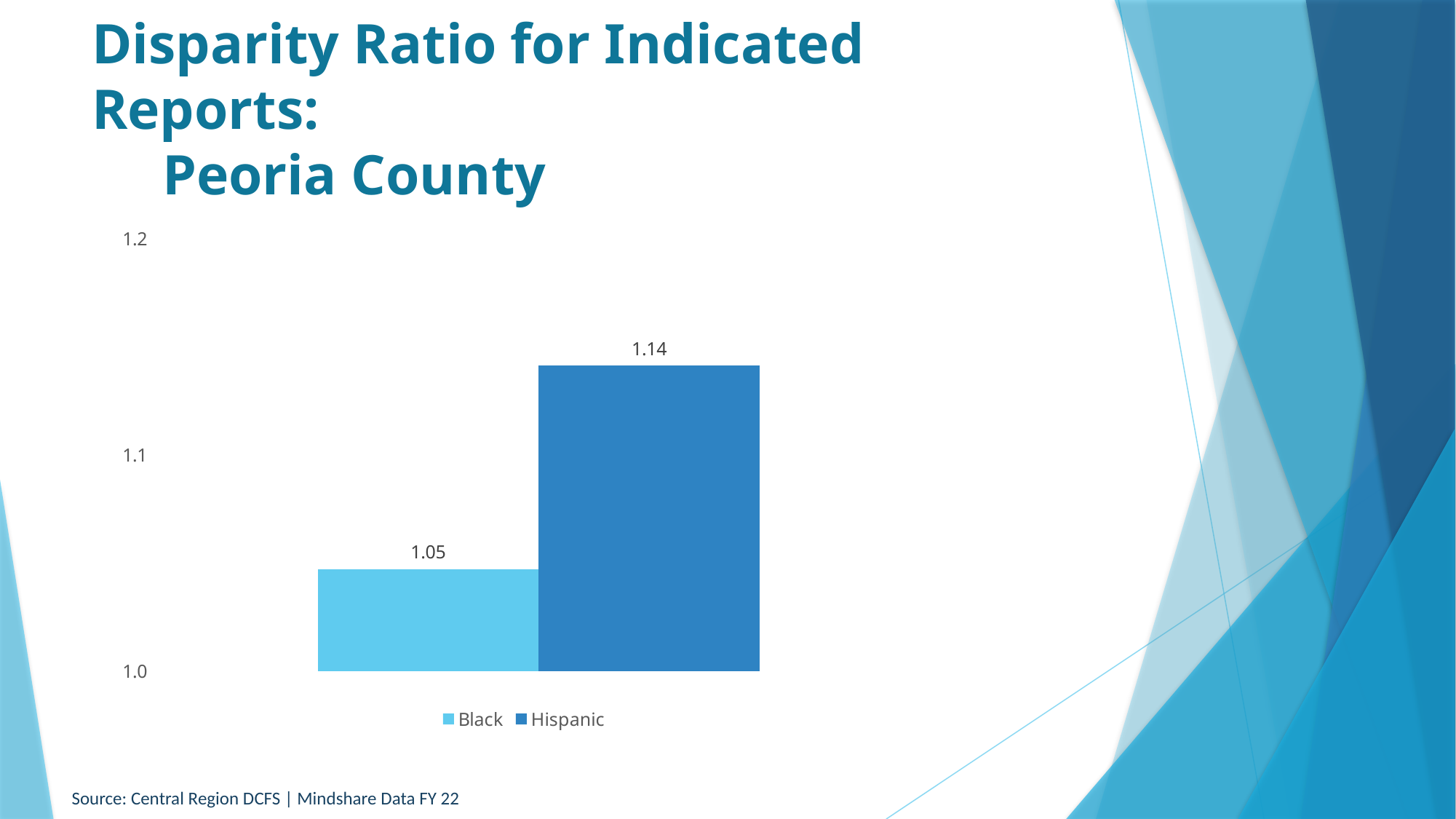
Is the value for Hispanic greater or less than 1.1? greater Is the disparity ratio for Black larger or smaller than the ratio for Hispanic? smaller What kind of chart is shown on the slide? bar chart What is the source cited for the chart data? Central Region DCFS | Mindshare Data FY 22 What is the disparity ratio for Hispanic? 1.14 How many bars are plotted in the chart? 2 Which group has the lower disparity ratio? Black What is the disparity ratio for Black? 1.05 Is the value for Black greater or less than 1.1? less Which group has the higher disparity ratio? Hispanic How many series does the legend list? 2 What is the difference between the Hispanic and Black disparity ratios? 0.09